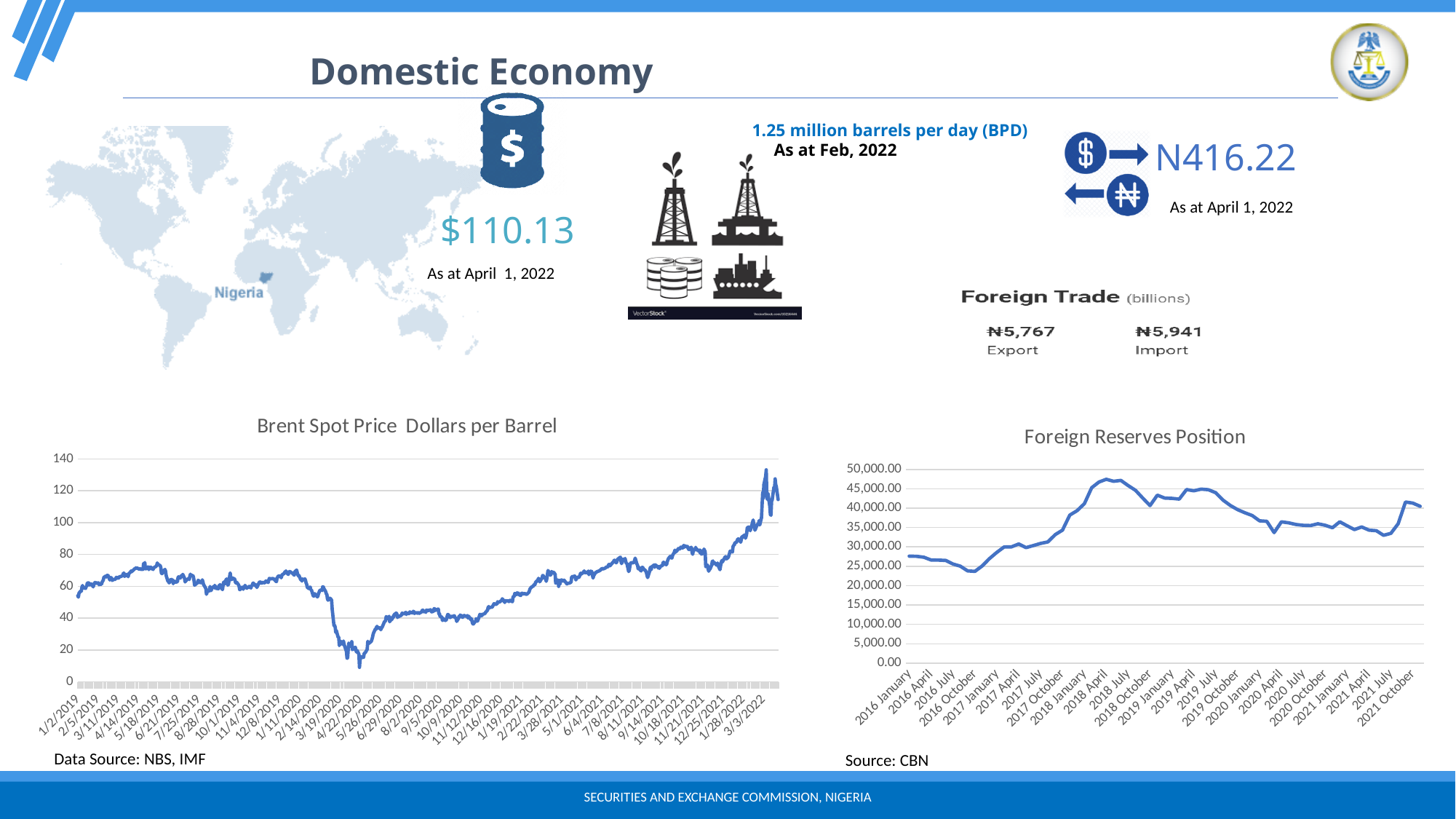
On the 'Brent Spot Price Dollars per Barrel' chart, is the value at 3/3/2022 greater or less than 100? greater What kind of chart is the 'Brent Spot Price Dollars per Barrel' chart? line chart On the 'Brent Spot Price Dollars per Barrel' chart, which is higher, the value around 3/3/2022 or the value around 4/22/2020? 3/3/2022 On the 'Brent Spot Price Dollars per Barrel' chart, is the value around 4/22/2020 greater or less than 20? less On the 'Brent Spot Price Dollars per Barrel' chart, is the value at 1/2/2019 greater or less than 40? greater On the 'Brent Spot Price Dollars per Barrel' chart, does the price rise or fall between 4/22/2020 and 3/3/2022? rise What kind of chart is the 'Foreign Reserves Position' chart? line chart What is the highest value shown on the y axis of the 'Foreign Reserves Position' chart? 50,000.00 On the 'Foreign Reserves Position' chart, which is higher, the value for 2018 April or the value for 2016 October? 2018 April